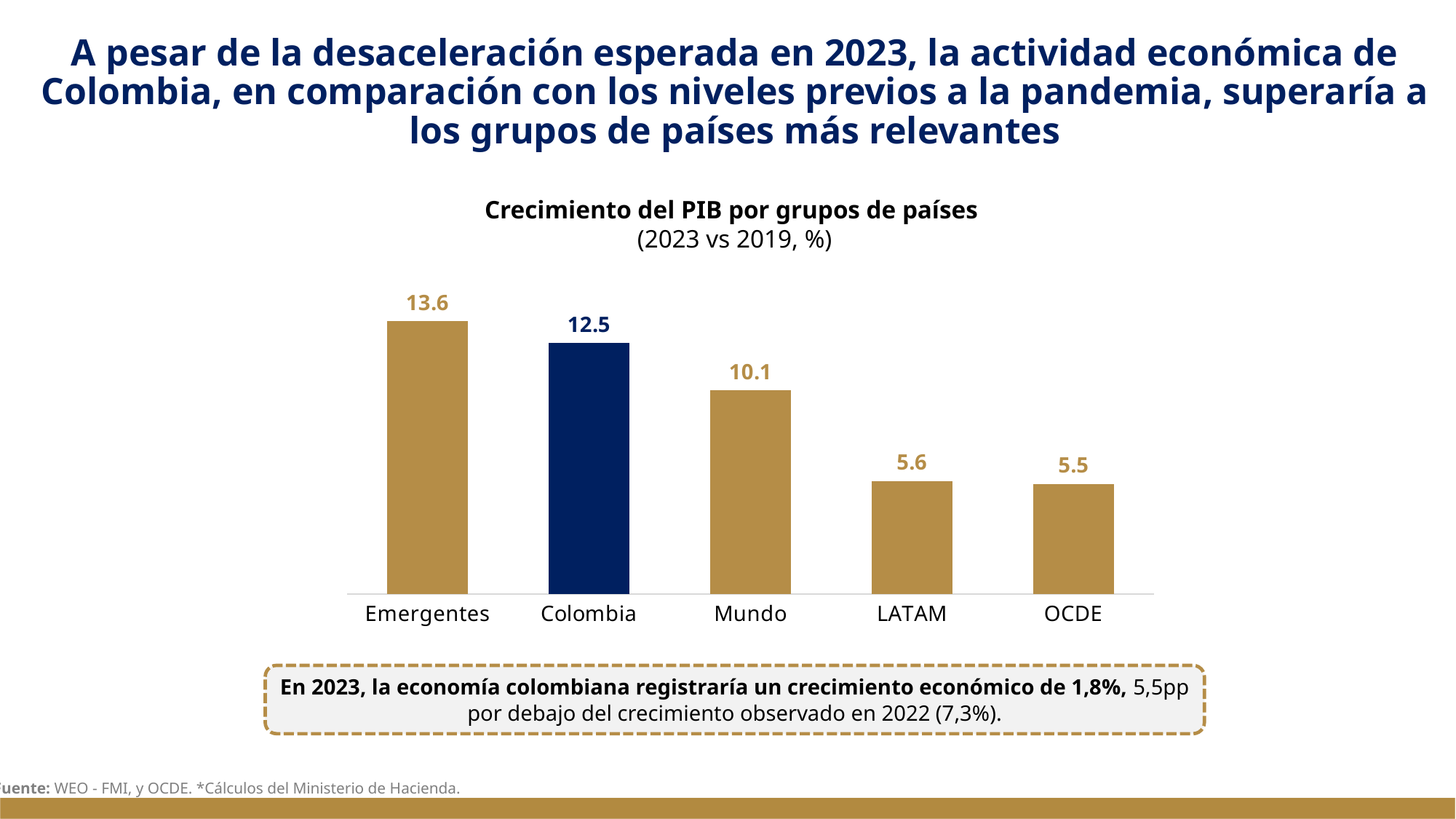
What is the value for Emergentes? 13.6 What is the difference between the values for Colombia and Mundo? 2.4 What is the value for Mundo? 10.1 What is the difference between the values for Emergentes and Colombia? 1.1 How many categories are shown in the chart? 5 Which is larger, the value for Colombia or the value for Mundo? Colombia What is the value for OCDE? 5.5 Which category has the highest value? Emergentes What is the value for Colombia? 12.5 What kind of chart is shown on the slide? Bar chart Do the values rise or fall from left to right across the categories? Fall What is the title of the chart? Crecimiento del PIB por grupos de países (2023 vs 2019, %)